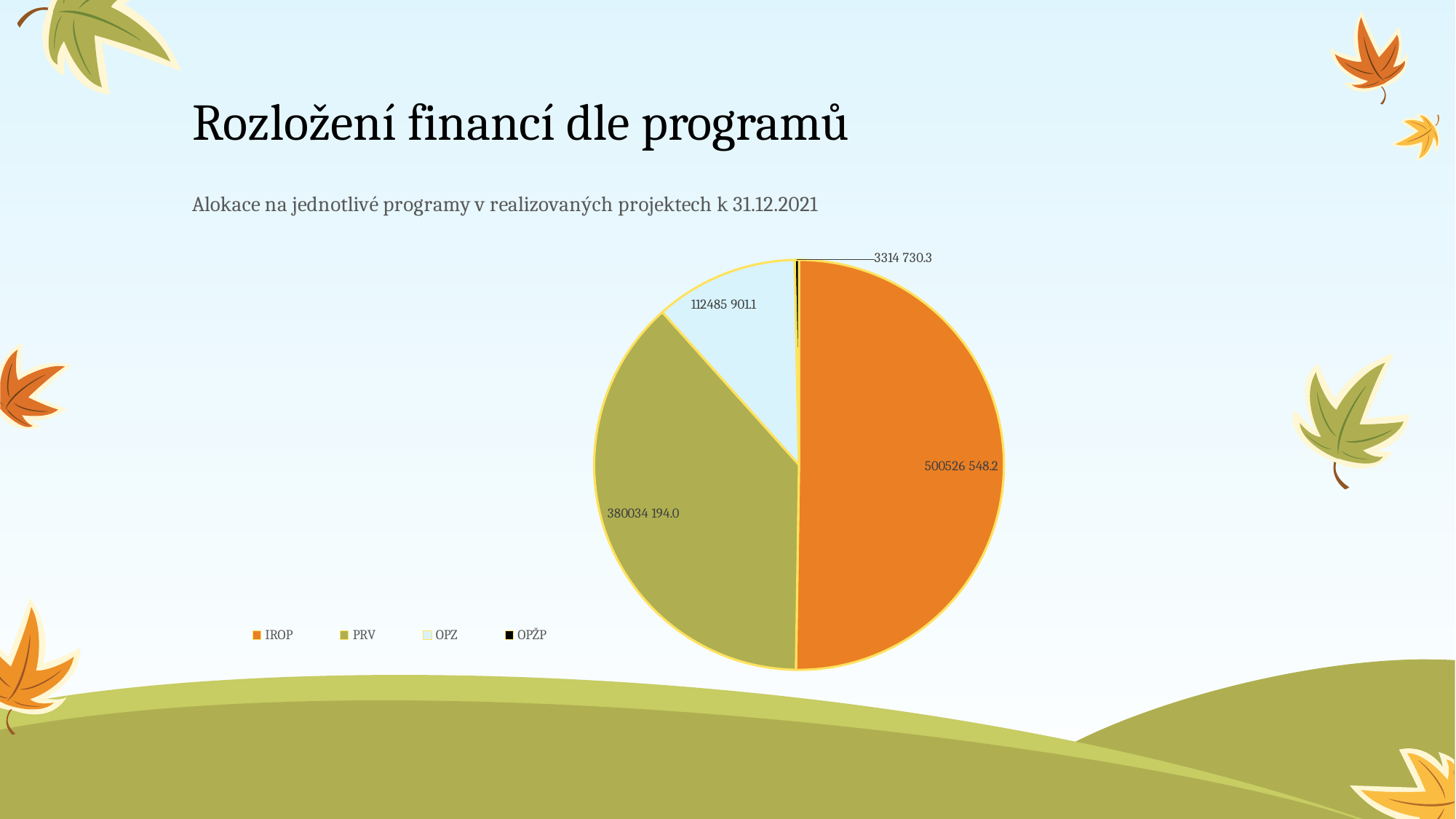
What is the value shown for PRV? 380034 194.0 What type of chart is shown on the slide? pie chart Which program has the smallest slice of the pie? OPŽP What is the difference between the values for IROP and PRV? 120492 354.2 What colour is the slice for OPZ? light blue What is the value shown for OPZ? 112485 901.1 What is the value shown for OPŽP? 3314 730.3 Which is larger, the value for PRV or the value for OPZ? PRV How many entries does the legend list? 4 How many slices does the pie chart have? 4 Which program has the largest slice of the pie? IROP What is the value shown for IROP? 500526 548.2